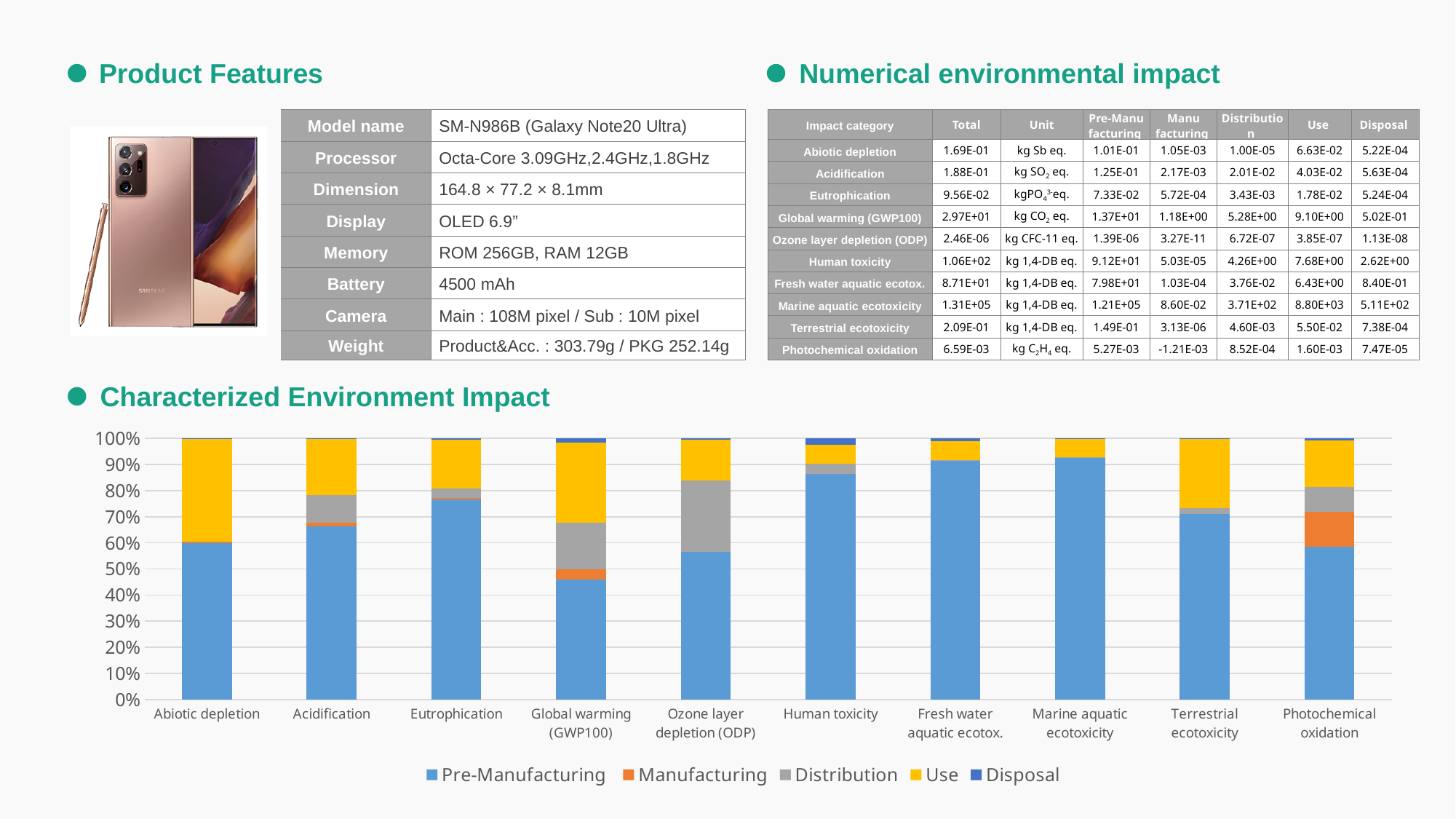
How many impact categories are plotted along the x axis of the Characterized Environment Impact chart? 10 In the Characterized Environment Impact chart, which has the larger Use share: Abiotic depletion or Acidification? Abiotic depletion How many series does the legend of the Characterized Environment Impact chart list? 5 Which series is shown in yellow in the Characterized Environment Impact chart? Use In the Characterized Environment Impact chart, what does each stacked bar total? 100% Which series is shown in orange in the Characterized Environment Impact chart? Manufacturing In the Characterized Environment Impact chart, which impact category has the smallest Pre-Manufacturing share? Global warming (GWP100) In the Characterized Environment Impact chart, is the Pre-Manufacturing share for Marine aquatic ecotoxicity greater or less than 90%? greater What kind of chart is shown under "Characterized Environment Impact"? Stacked bar chart In the Characterized Environment Impact chart, is the Pre-Manufacturing share for Abiotic depletion greater or less than 50%? greater In the Characterized Environment Impact chart, is the Pre-Manufacturing share for Global warming (GWP100) greater or less than 50%? less In the Characterized Environment Impact chart, which has the larger Pre-Manufacturing share: Abiotic depletion or Acidification? Acidification